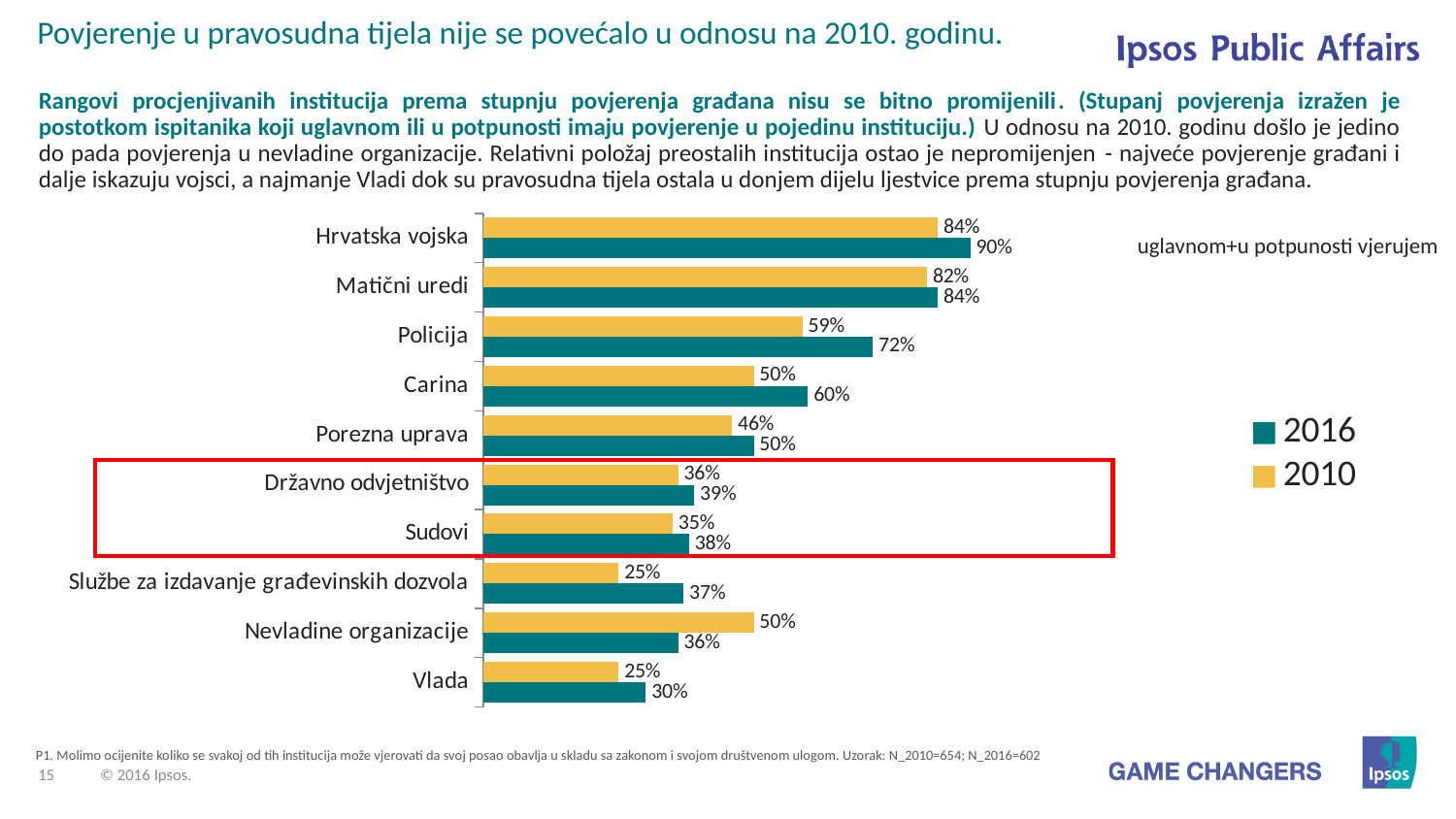
How many categories are shown in the chart? 10 How many series does the legend list? 2 What kind of chart is shown on the slide? Bar chart What is the 2016 value for Hrvatska vojska? 90% Which category has the highest 2016 value? Hrvatska vojska Which category has the lowest 2016 value? Vlada What is the difference between the 2016 and 2010 values for Policija? 13% Which two categories are outlined with a red box on the chart? Državno odvjetništvo and Sudovi Which is larger for Nevladine organizacije, the 2010 value or the 2016 value? 2010 What is the 2010 value for Policija? 59% What is the difference between the 2016 and 2010 values for Službe za izdavanje građevinskih dozvola? 12% What is the 2016 value for Nevladine organizacije? 36%